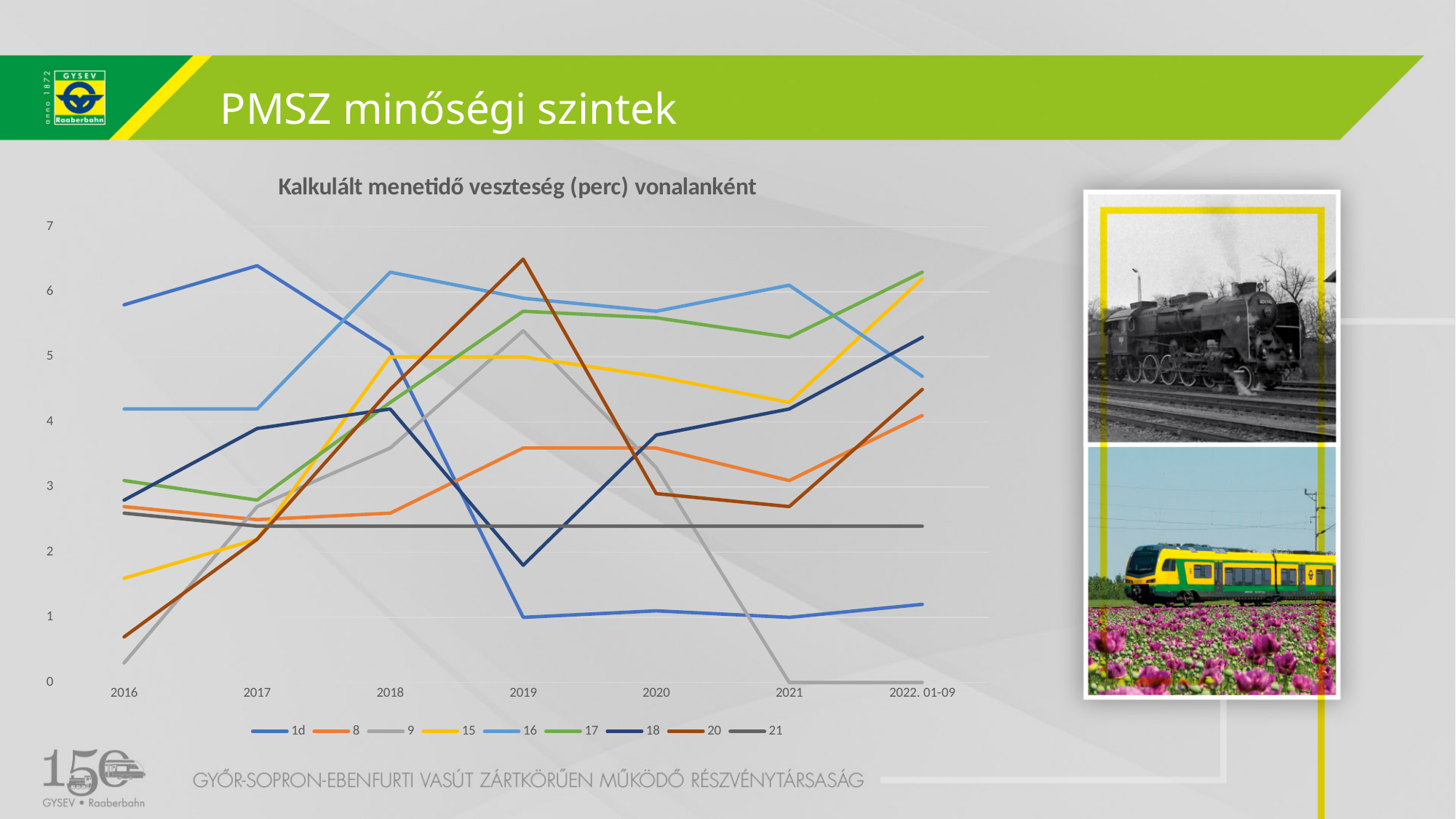
Does the value for series 9 rise or fall from 2019 to 2021? fall Is the value for series 1d in 2017 greater or less than 6? greater What kind of chart is shown on the slide? line chart Is the value for series 20 in 2019 greater or less than 6? greater What is the title of the chart? Kalkulált menetidő veszteség (perc) vonalanként How many points are there along the x axis? 7 Which series has the lowest value in 2016? 9 Is the value for series 21 in 2020 greater or less than 3? less How many series does the legend list? 9 Which series has the highest value in 2019? 20 In 2016, which is larger: the value for series 1d or the value for series 9? 1d